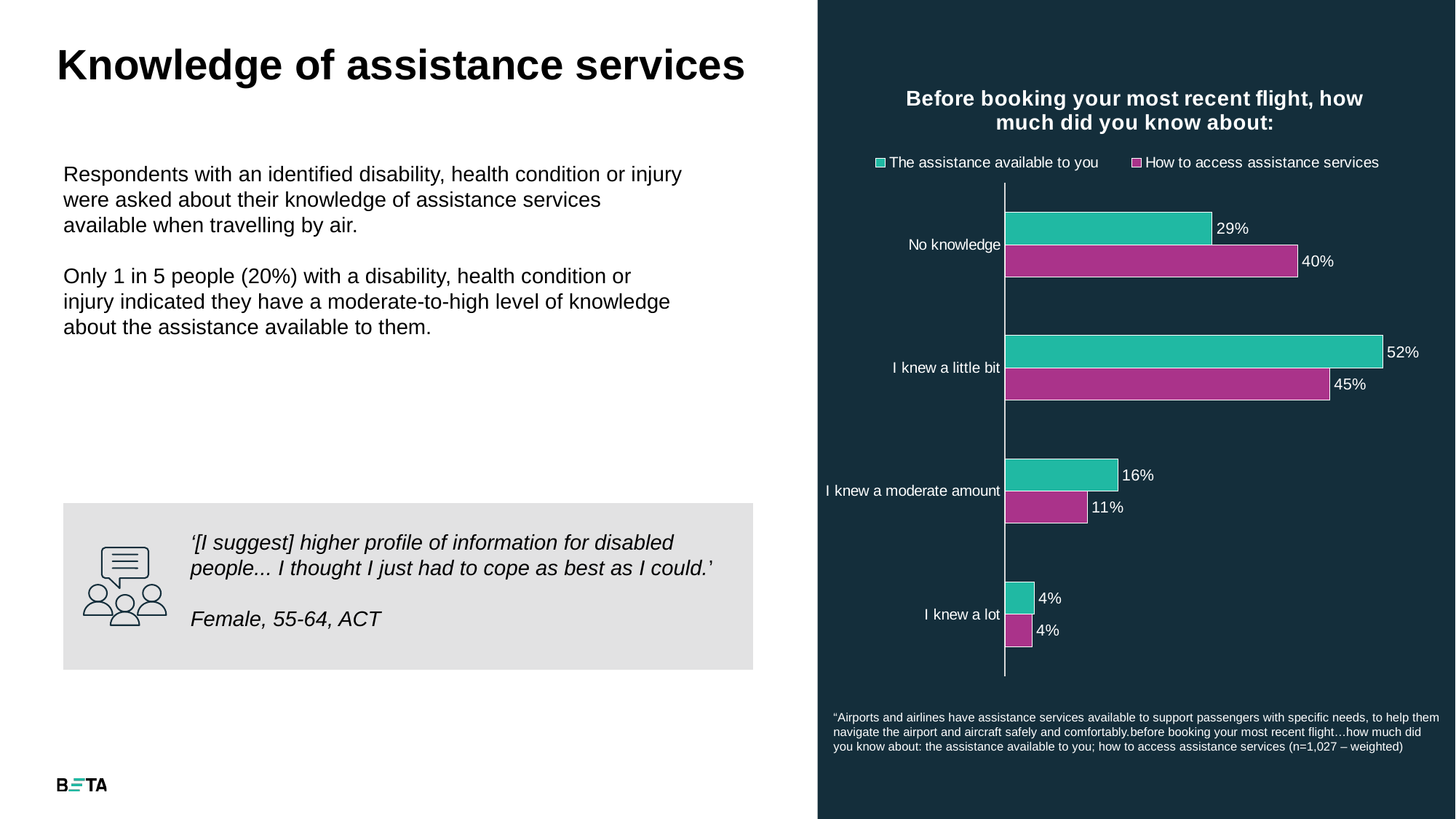
What colour are the bars for 'How to access assistance services'? Magenta/purple Which category has the lowest value for 'How to access assistance services'? I knew a lot What is the difference between the two series for 'No knowledge'? 11 percentage points How many categories are shown on the chart? 4 Which category has the highest value for 'The assistance available to you'? I knew a little bit What is the value for 'I knew a little bit' in the 'The assistance available to you' series? 52% What type of chart is shown on the slide? Bar chart How many series does the legend list? 2 What percentage of respondents had no knowledge of how to access assistance services? 40% What is the value for 'I knew a moderate amount' in the 'How to access assistance services' series? 11% For 'I knew a little bit', which series has the larger value? The assistance available to you What percentage of respondents had no knowledge of the assistance available to them? 29%